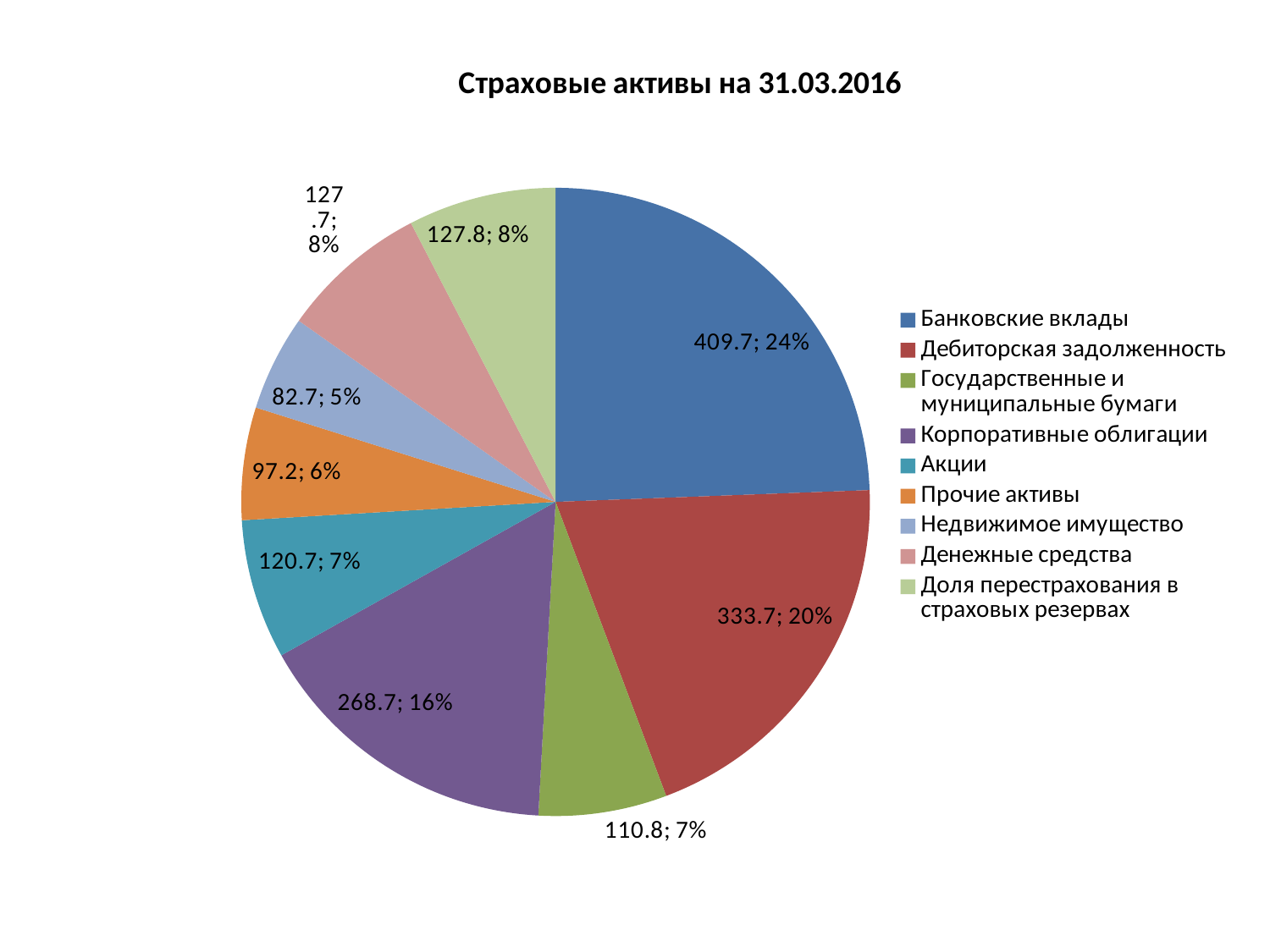
Which is larger, the value for Акции or the value for Прочие активы? Акции What share of the pie does Недвижимое имущество represent? 5% Which category has the smallest slice of the pie? Недвижимое имущество How many categories does the legend list? 9 What is the value shown for Государственные и муниципальные бумаги? 110.8 What is the title of the chart? Страховые активы на 31.03.2016 What share of the pie does Дебиторская задолженность represent? 20% What is the value shown for Корпоративные облигации? 268.7 Which category has the largest slice of the pie? Банковские вклады What is the difference between the values for Банковские вклады and Дебиторская задолженность? 76 What type of chart is shown on the slide? pie chart What is the value shown for Банковские вклады? 409.7